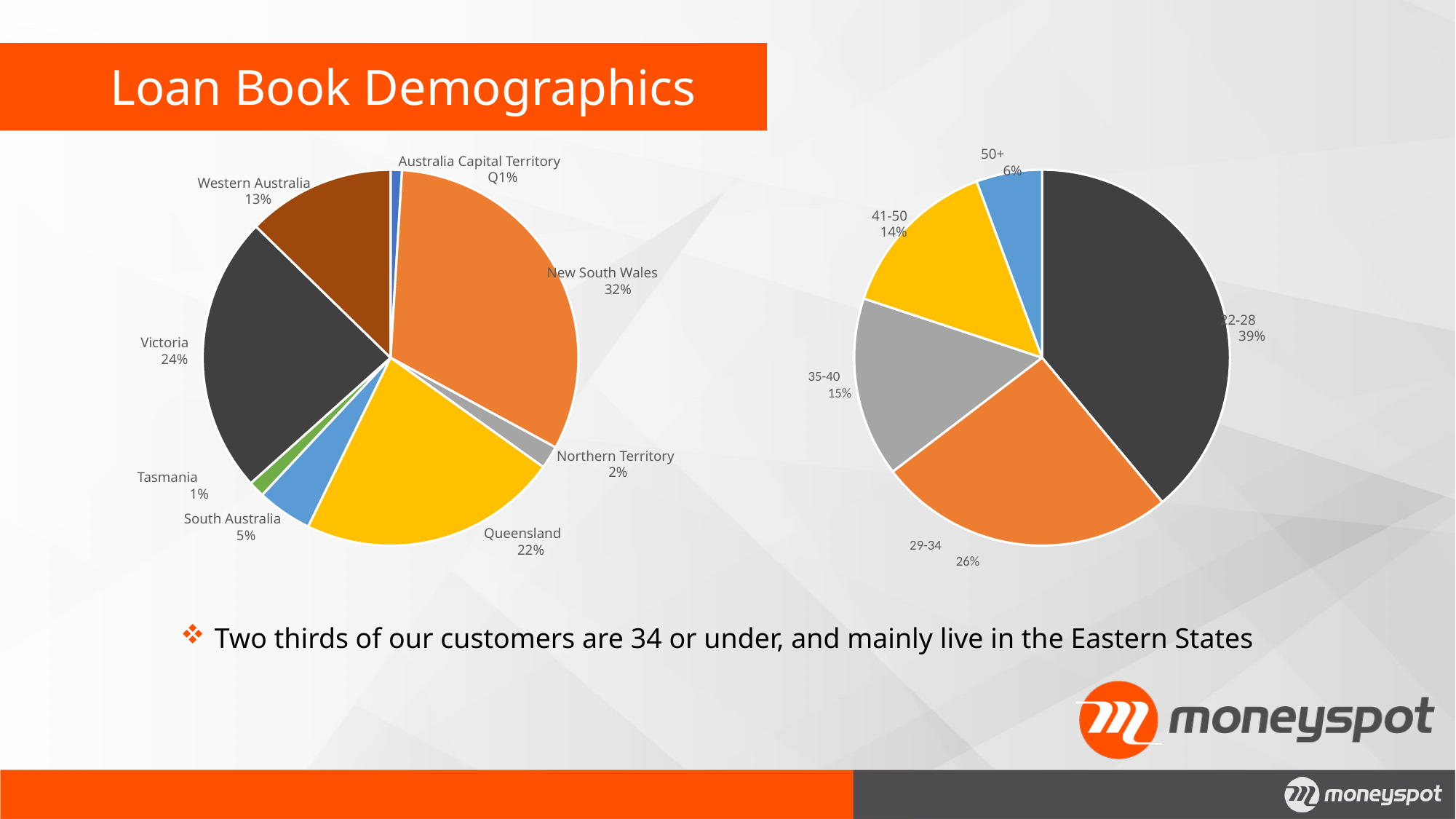
In the right pie chart, what is the difference between the shares of the 29-34 and 35-40 age groups? 11% How many slices does the left pie chart have? 8 In the left pie chart, what is the difference between the shares of Queensland and Western Australia? 9% In the right pie chart, what colour is the slice for the 41-50 age group? Yellow In the left pie chart, which is larger, the share for South Australia or the share for Northern Territory? South Australia In the left pie chart, which state or territory has the largest share? New South Wales How many age groups are shown in the right pie chart? 5 In the left pie chart, what percentage is shown for Victoria? 24% In the left pie chart, what share of the loan book is New South Wales? 32% What type of chart is the right chart on the slide? Pie chart In the right pie chart, what share is shown for the 22-28 age group? 39% In the right pie chart, which age group has the smallest share? 50+